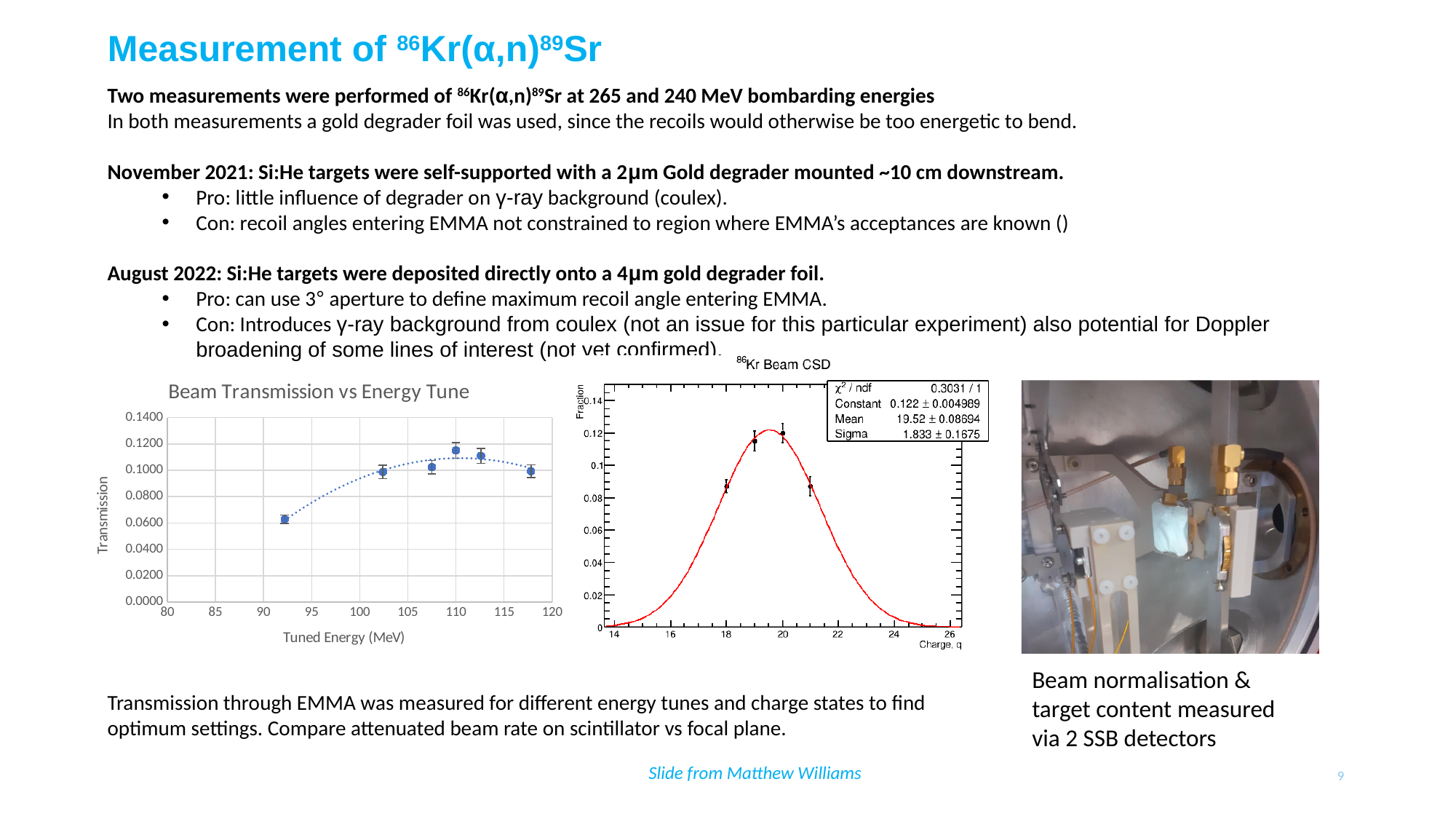
In the 'Beam Transmission vs Energy Tune' chart, is the highest transmission value greater or less than 0.1000? greater In the '86Kr Beam CSD' chart, which has the larger fraction, charge state 18 or charge state 20? charge state 20 In the '86Kr Beam CSD' chart, what is the label of the x axis? Charge, q In the 'Beam Transmission vs Energy Tune' chart, how many data points are plotted? 6 In the 'Beam Transmission vs Energy Tune' chart, does the lowest transmission occur at the lowest or the highest tuned energy? lowest In the 'Beam Transmission vs Energy Tune' chart, does transmission rise or fall as tuned energy increases from 90 to 110 MeV? rise In the '86Kr Beam CSD' chart, what is the fitted Sigma value shown in the statistics box? 1.833 What is the title of the left-hand chart on the slide? Beam Transmission vs Energy Tune In the '86Kr Beam CSD' chart, is the fraction at charge state 20 greater or less than 0.1? greater In the 'Beam Transmission vs Energy Tune' chart, is the transmission at the lowest tuned energy (around 92 MeV) greater or less than 0.0800? less What kind of chart is the 'Beam Transmission vs Energy Tune' chart? scatter chart In the '86Kr Beam CSD' chart, what is the fitted Mean value shown in the statistics box? 19.52